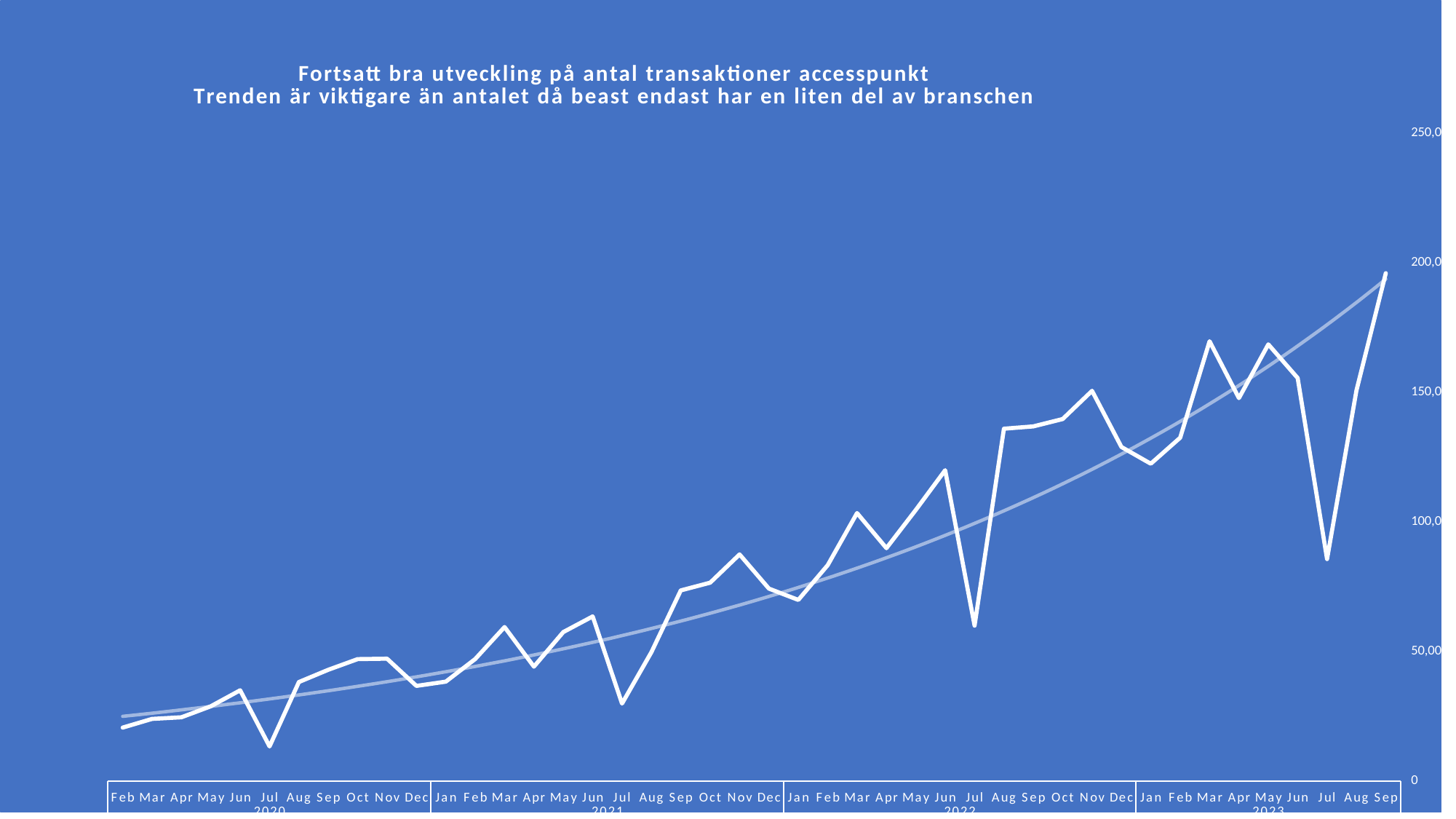
Is the value for Sep 2023 greater or less than 150,00? greater Which is larger, the value for Dec 2022 or the value for Dec 2020? Dec 2022 Is the value for Jul 2020 greater or less than 50,00? less Is the value for Jul 2023 greater or less than 100,00? less Which month has the lowest value on the chart? Jul 2020 What is the first line of the chart title? Fortsatt bra utveckling på antal transaktioner accesspunkt What kind of chart is shown on the slide? line chart How many years are labelled on the x axis? 4 Which month has the highest value on the chart? Sep 2023 Which is larger, the value for Sep 2023 or the value for Jul 2023? Sep 2023 Overall, do the values rise or fall from Feb 2020 to Sep 2023? rise